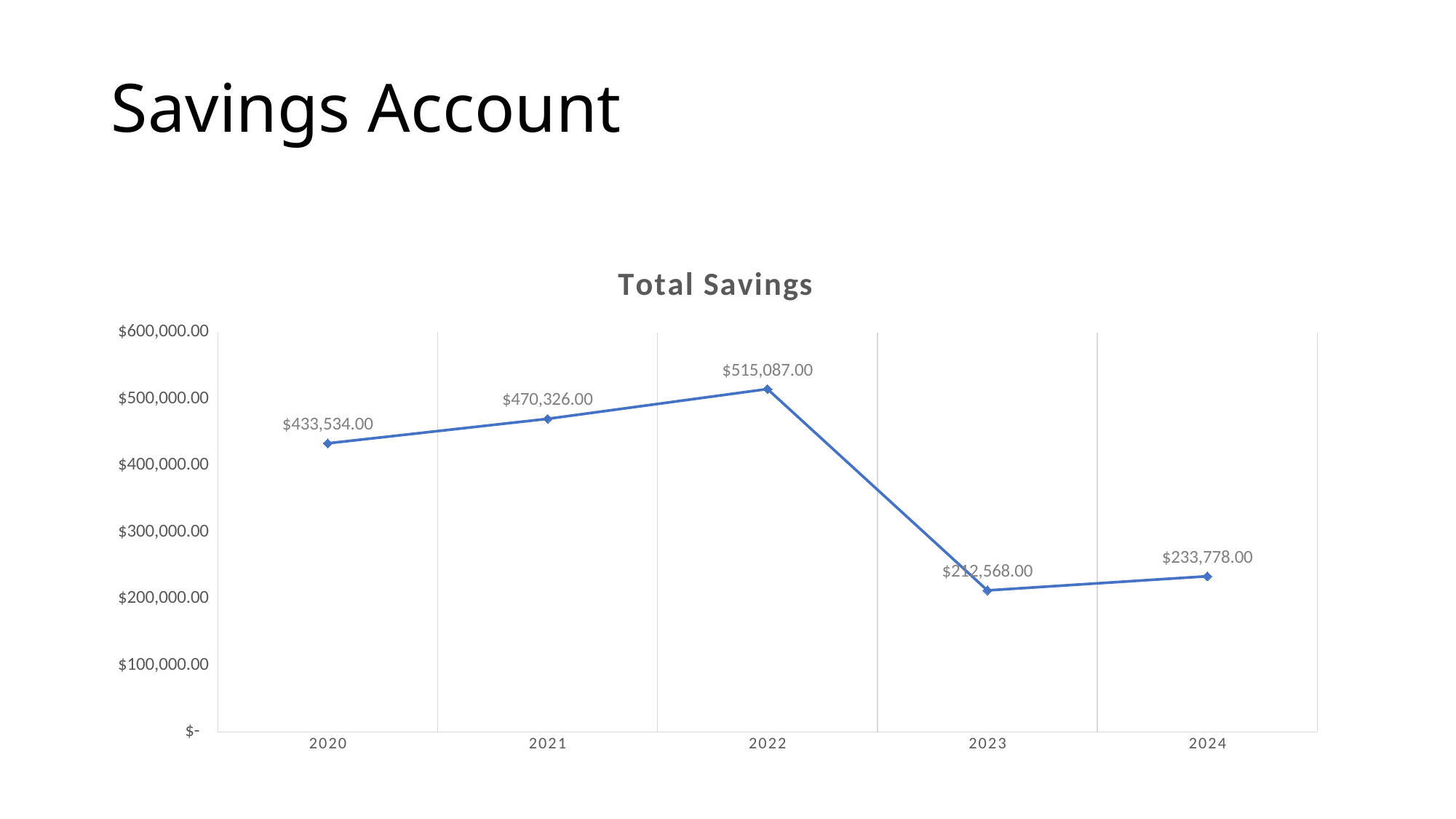
What is the difference between the values for 2024 and 2023? $21,210.00 Is the value for 2023 greater or less than $300,000.00? less What is the value for 2020? $433,534.00 What is the difference between the values for 2022 and 2021? $44,761.00 What kind of chart is shown on the slide? line chart Which year has the highest total savings? 2022 What is the title of the chart? Total Savings What is the value for 2024? $233,778.00 Which is larger, the value for 2021 or the value for 2024? 2021 What is the value for 2022? $515,087.00 Which year has the lowest total savings? 2023 How many years are plotted on the chart? 5